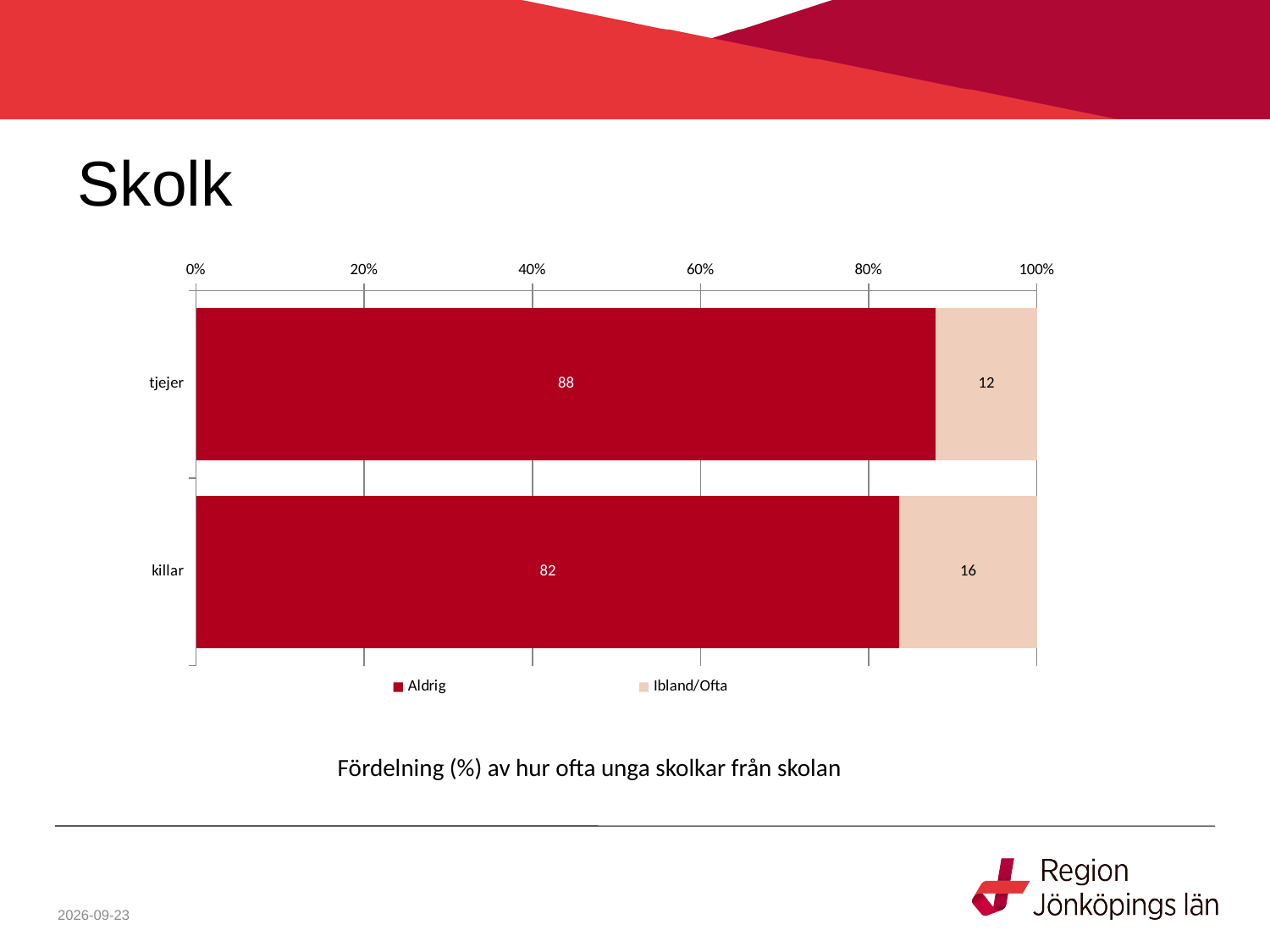
How many categories are shown on the chart? 2 What is the difference between the Ibland/Ofta values for killar and tjejer? 4 What is the value for Ibland/Ofta for tjejer? 12 Which category has the higher value for Aldrig, tjejer or killar? tjejer Which category has the highest value for Ibland/Ofta? killar What is the difference between the Aldrig values for tjejer and killar? 6 How many series does the legend list? 2 What kind of chart is shown on the slide? stacked bar chart What is the value for Aldrig for killar? 82 What is the value for Ibland/Ofta for killar? 16 What is the caption text below the chart? Fördelning (%) av hur ofta unga skolkar från skolan What is the value for Aldrig for tjejer? 88